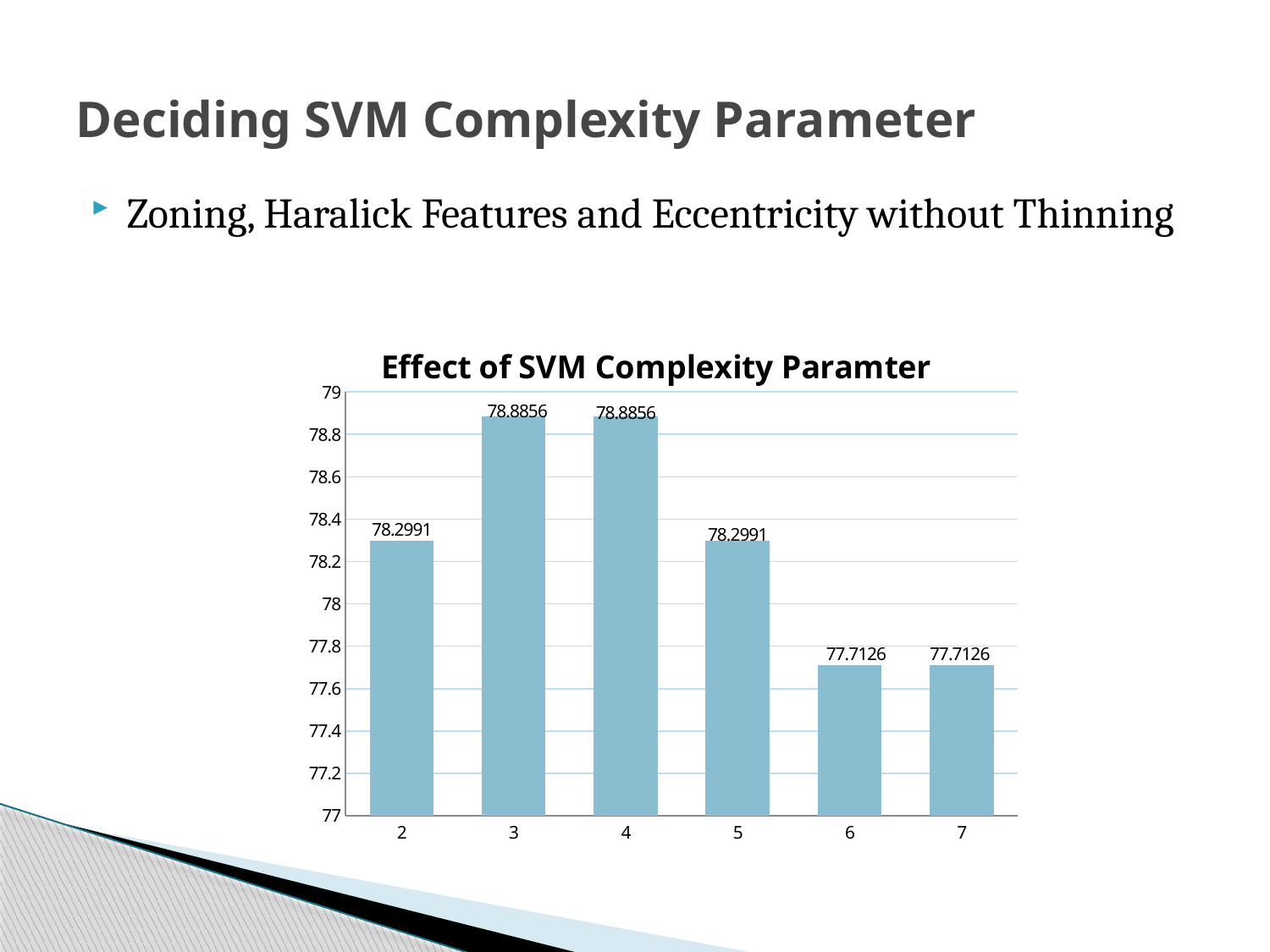
What is the value for complexity parameter 5 in the chart? 78.2991 What is the difference between the values for complexity parameter 4 and complexity parameter 7? 1.173 Which has a larger value, complexity parameter 2 or complexity parameter 6? complexity parameter 2 What is the title of the chart? Effect of SVM Complexity Paramter What is the value for complexity parameter 6 in the chart? 77.7126 What is the lowest value shown in the chart? 77.7126 How many complexity parameter values are plotted in the chart? 6 Is the value for complexity parameter 4 greater or less than 78.6? greater What is the value for complexity parameter 3 in the chart? 78.8856 What is the highest value shown in the chart? 78.8856 What is the difference between the values for complexity parameter 3 and complexity parameter 2? 0.5865 What kind of chart is shown on the slide? bar chart